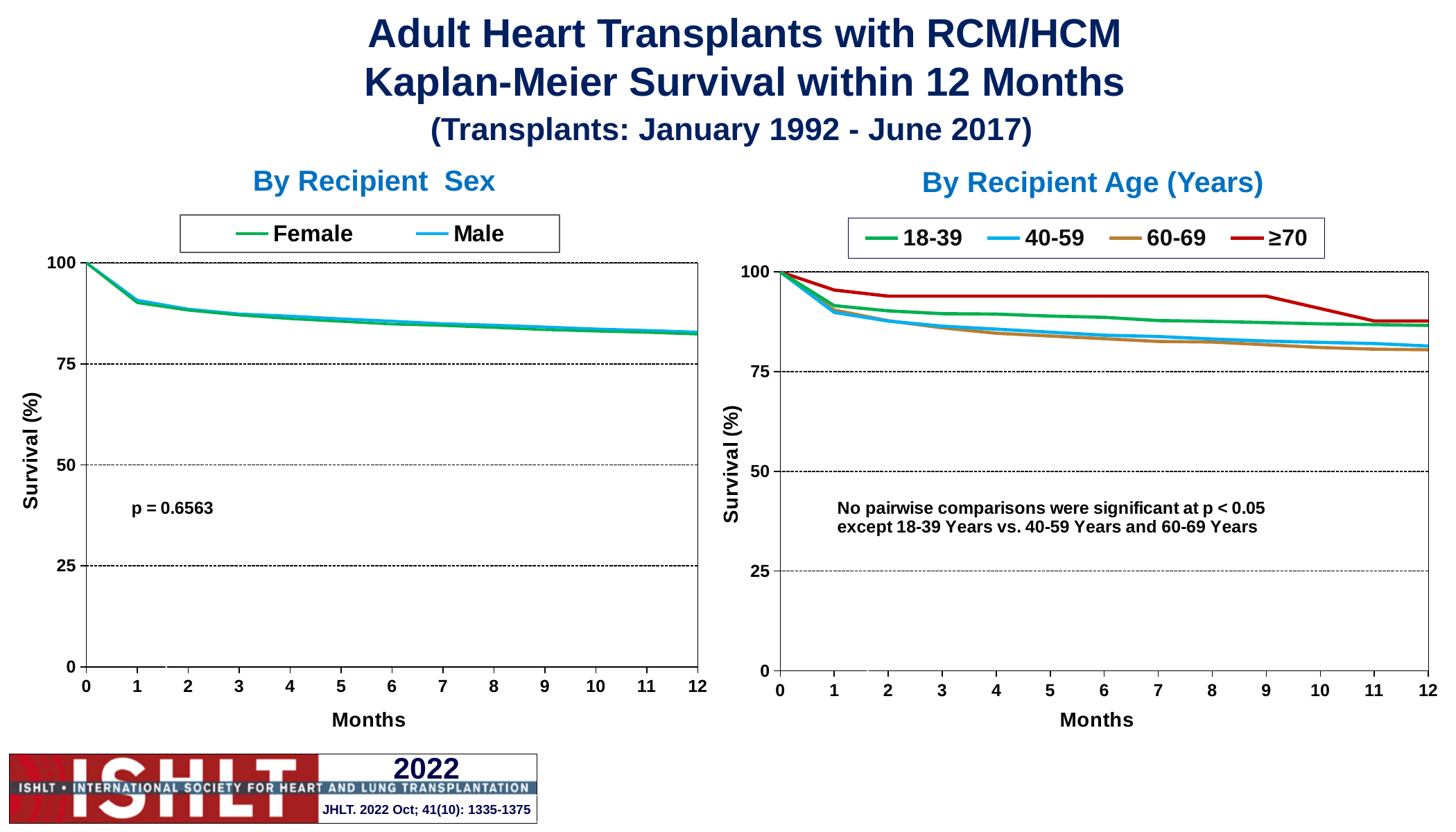
In the 'By Recipient Age (Years)' chart, which age group has the highest survival at month 6? ≥70 What type of chart is the 'By Recipient Sex' chart? line chart In the 'By Recipient Sex' chart, do the survival values rise or fall as months increase? fall In the 'By Recipient Sex' chart, is the value for Male at month 12 greater or less than 75? greater In the 'By Recipient Age (Years)' chart, is the value for ≥70 at month 9 greater or less than 75? greater How many series does the legend of the 'By Recipient Sex' chart list? 2 What is the x-axis label of the 'By Recipient Age (Years)' chart? Months How many series does the legend of the 'By Recipient Age (Years)' chart list? 4 In the 'By Recipient Age (Years)' chart, what is the survival value for 18-39 at month 0? 100 What p-value is printed on the 'By Recipient Sex' chart? p = 0.6563 In the 'By Recipient Sex' chart, what is the survival value for Female at month 0? 100 In the 'By Recipient Age (Years)' chart, at month 6, is survival higher for ≥70 or for 60-69? ≥70